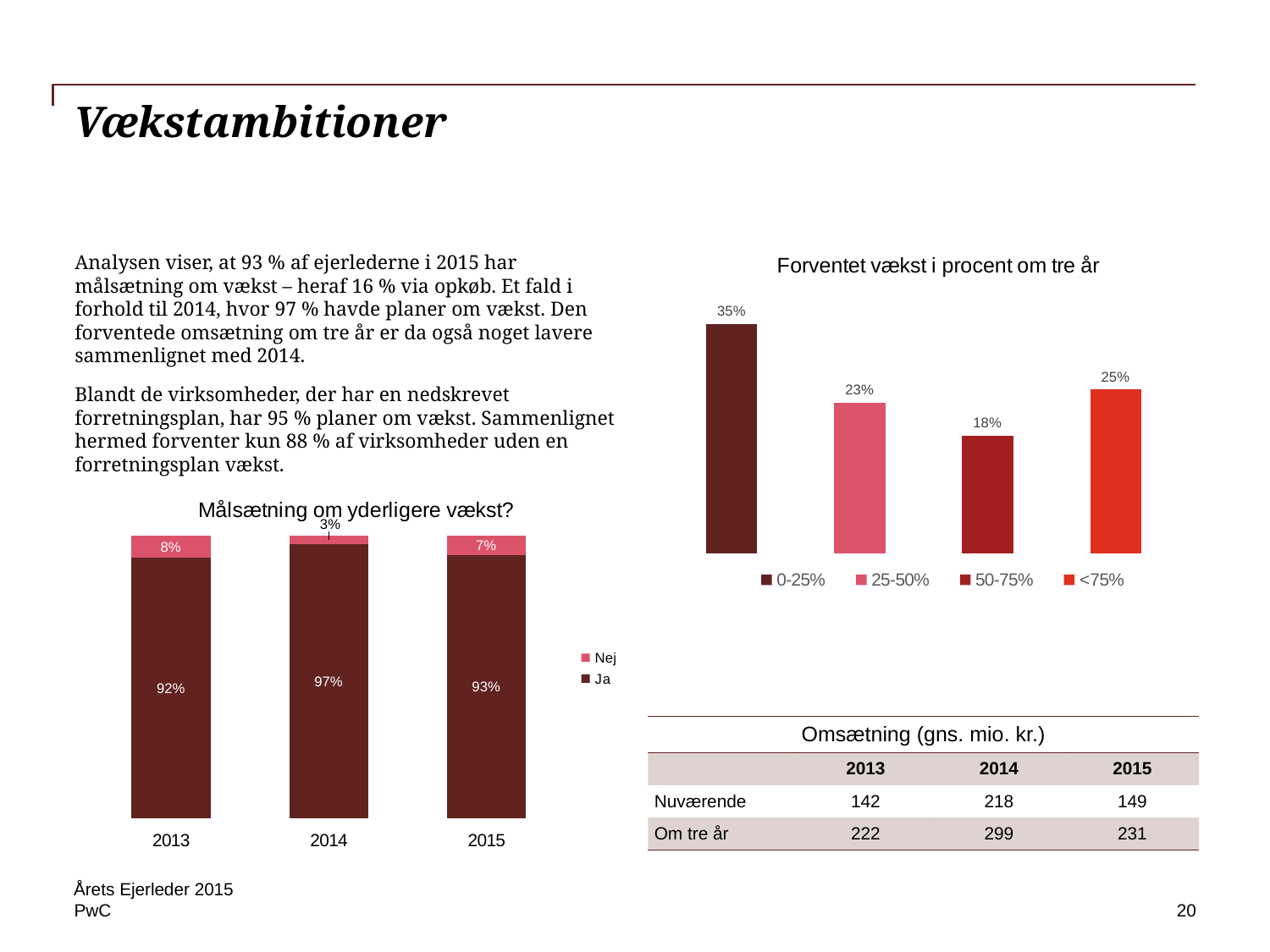
In the chart 'Forventet vækst i procent om tre år', what is the value for '50-75%'? 18% In the chart 'Forventet vækst i procent om tre år', which category has the lowest value? 50-75% What kind of chart is 'Forventet vækst i procent om tre år'? Bar chart In the chart 'Forventet vækst i procent om tre år', which is larger: the value for '25-50%' or the value for '<75%'? <75% In the chart 'Forventet vækst i procent om tre år', which category has the highest value? 0-25% In the chart 'Målsætning om yderligere vækst?', how many series does the legend list? 2 In the chart 'Forventet vækst i procent om tre år', what is the difference between the values for '0-25%' and '25-50%'? 12 percentage points In the chart 'Målsætning om yderligere vækst?', what is the value for 'Ja' in 2014? 97% In the chart 'Målsætning om yderligere vækst?', what is the value for 'Nej' in 2013? 8% In the chart 'Målsætning om yderligere vækst?', which year has the lowest 'Ja' value? 2013 In the chart 'Målsætning om yderligere vækst?', what is the total of the stacked bar for 2015? 100% In the chart 'Målsætning om yderligere vækst?', what is the difference between the 'Ja' values for 2014 and 2015? 4 percentage points